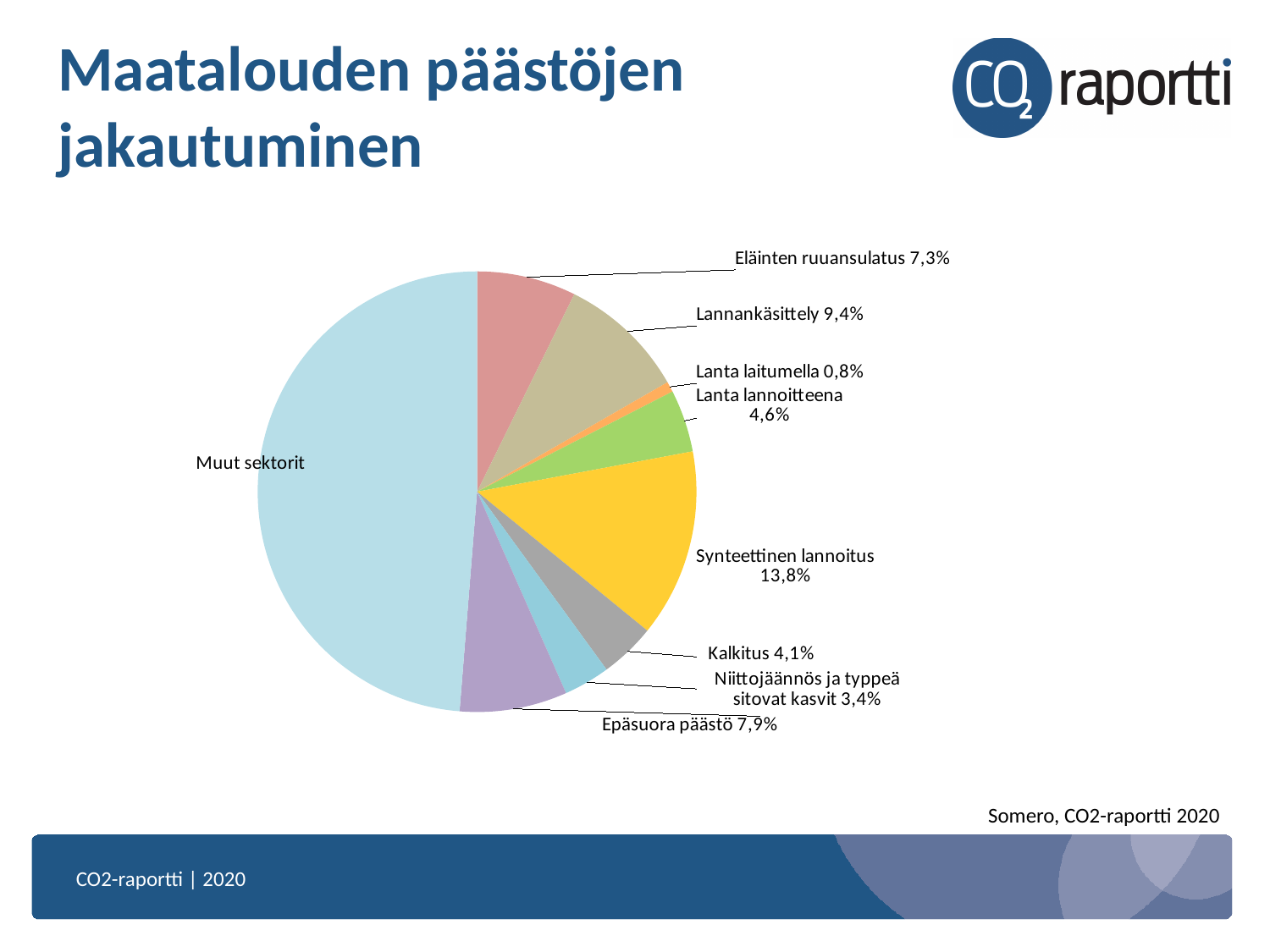
Which labelled category has the smallest share in the pie chart? Lanta laitumella What is the share of Synteettinen lannoitus in the pie chart? 13,8% What is the value labelled for Lanta laitumella? 0,8% Which slice of the pie chart is the largest? Muut sektorit What percentage is given for Niittojäännös ja typpeä sitovat kasvit? 3,4% What share does Epäsuora päästö have in the chart? 7,9% What is the title of the slide containing the pie chart? Maatalouden päästöjen jakautuminen Which has a larger share, Epäsuora päästö or Eläinten ruuansulatus? Epäsuora päästö What percentage is shown for Lannankäsittely? 9,4% What type of chart is shown on the slide? Pie chart How many slices does the pie chart have? 9 What is the difference between the shares of Synteettinen lannoitus and Lannankäsittely? 4,4%